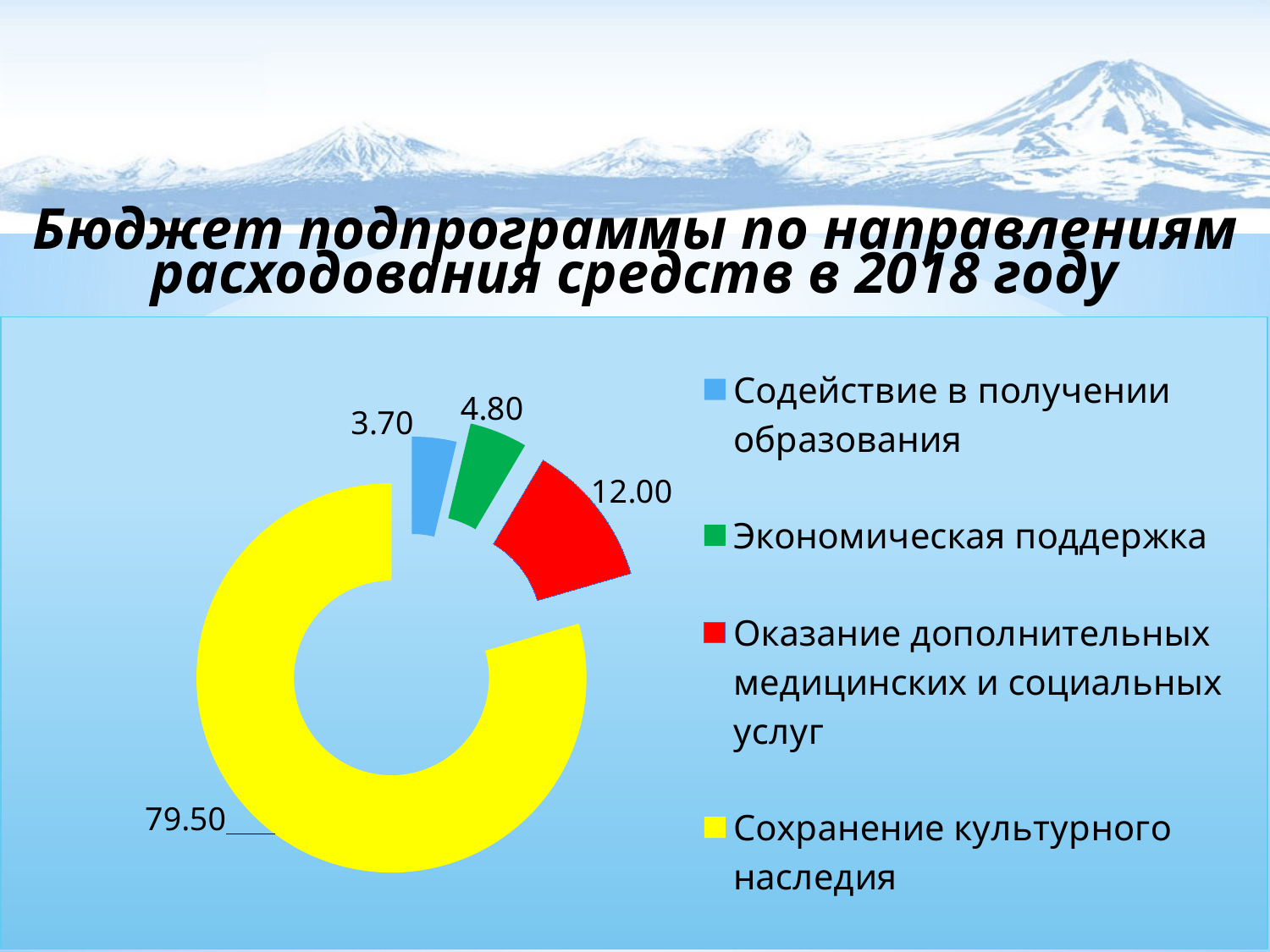
What is the total of all the values shown in the chart? 100.00 What value is shown for Сохранение культурного наследия? 79.50 What is the difference between the values for Оказание дополнительных медицинских и социальных услуг and Экономическая поддержка? 7.20 What value is shown for Оказание дополнительных медицинских и социальных услуг? 12.00 Which is larger: the value for Экономическая поддержка or the value for Содействие в получении образования? Экономическая поддержка How many categories are shown in the chart? 4 Which category has the smallest share of the chart? Содействие в получении образования Which category has the largest share of the chart? Сохранение культурного наследия What kind of chart is shown on the slide? Doughnut (pie) chart Which colour represents Оказание дополнительных медицинских и социальных услуг in the chart? Red What value is shown for Экономическая поддержка? 4.80 What value is shown for Содействие в получении образования? 3.70